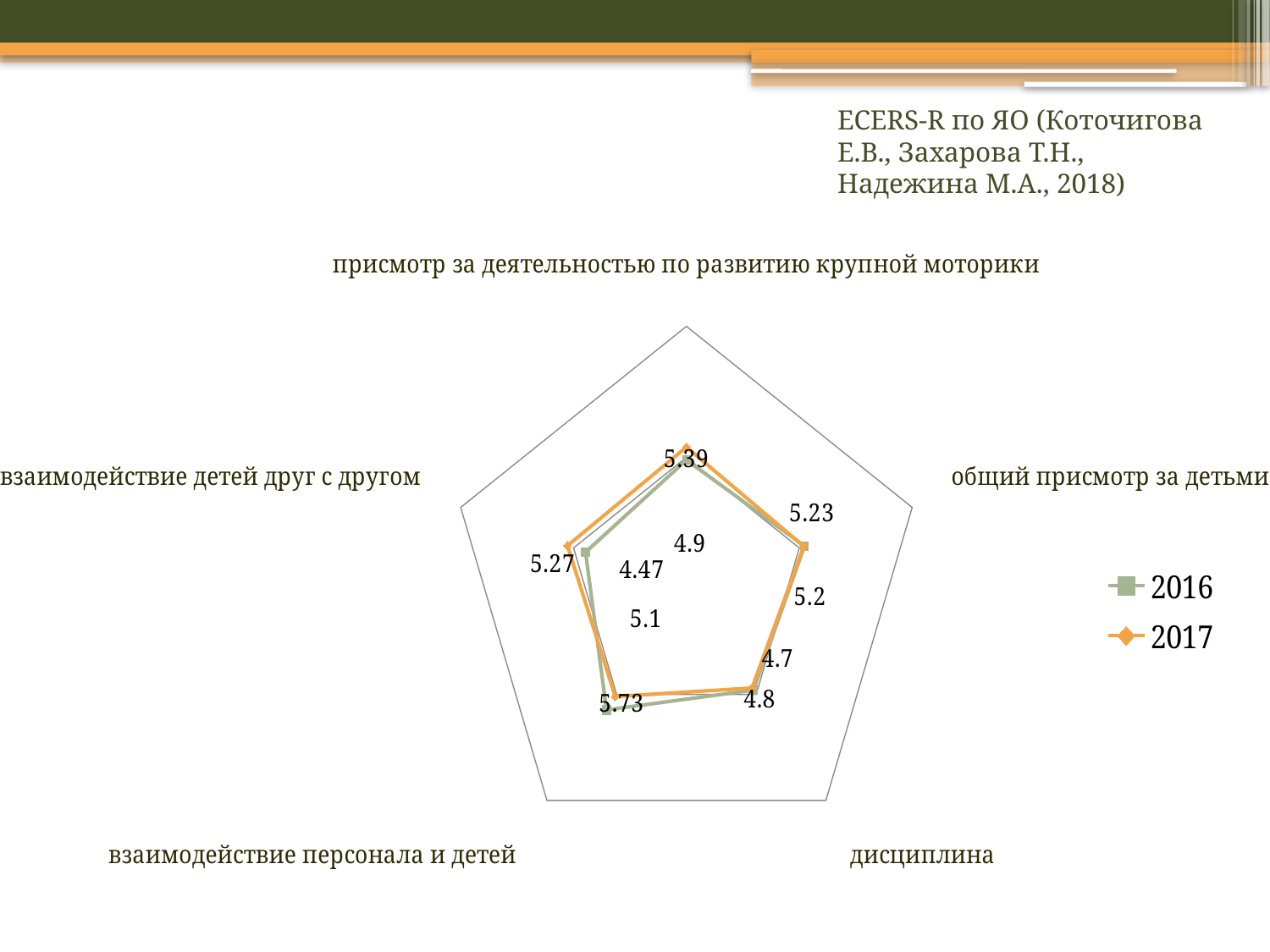
What kind of chart is shown on the slide? radar chart How many series does the legend list? 2 Which years are listed in the legend? 2016 and 2017 How many categories (axes) does the radar chart have? 5 What is the lowest data label value shown on the chart? 4.47 What is the highest data label value shown on the chart? 5.73